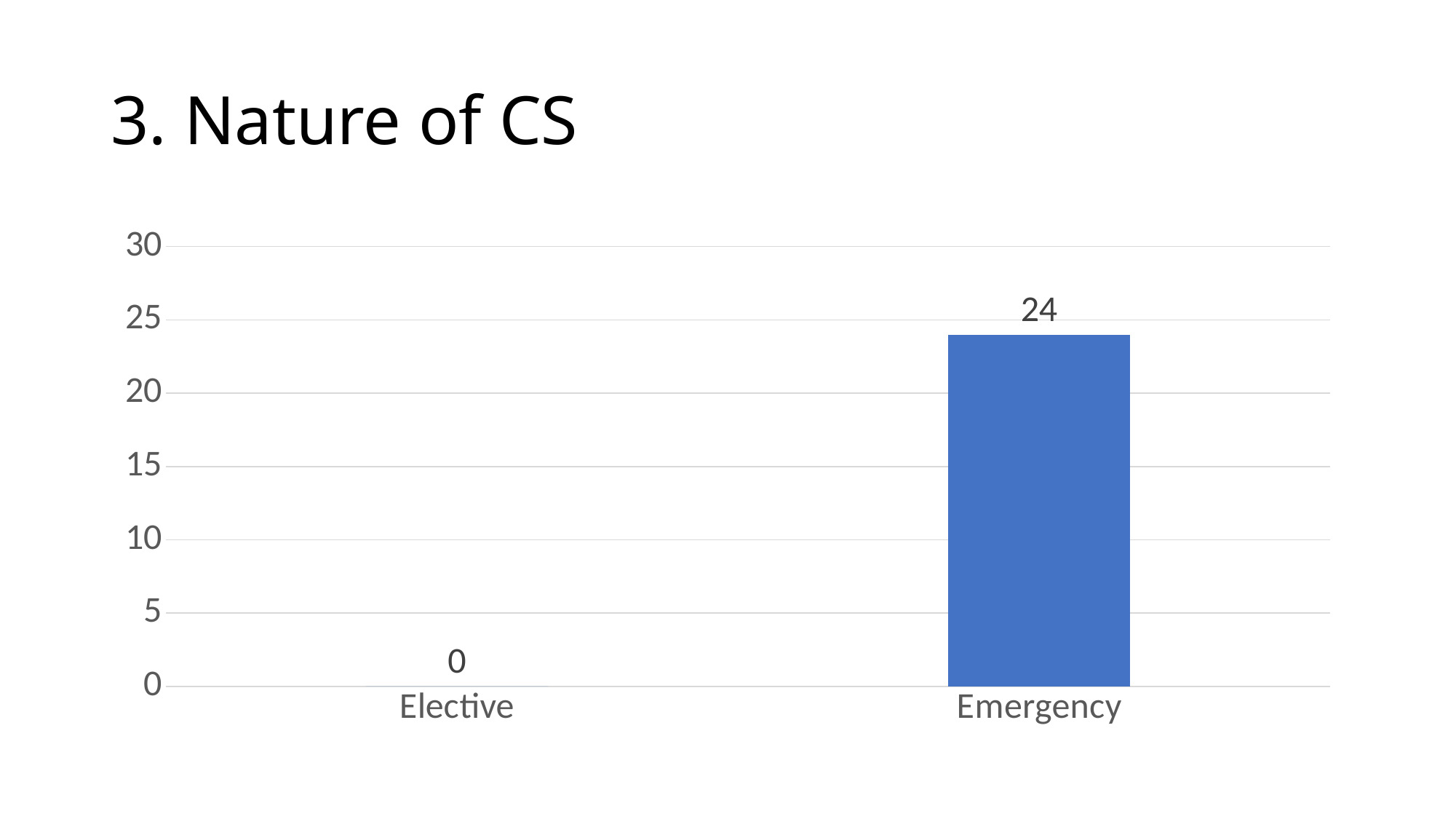
Which is larger, the value for Elective or the value for Emergency? Emergency What is the value for Elective? 0 How many categories are shown on the x axis? 2 Is the value for Emergency greater or less than 25? less What is the difference between the values for Emergency and Elective? 24 Which category has the lowest value? Elective What kind of chart is shown on the slide? bar chart What is the value for Emergency? 24 Is the value for Emergency greater or less than 20? greater What is the title of the slide? 3. Nature of CS Which category has the highest value? Emergency What is the highest value shown on the y axis? 30